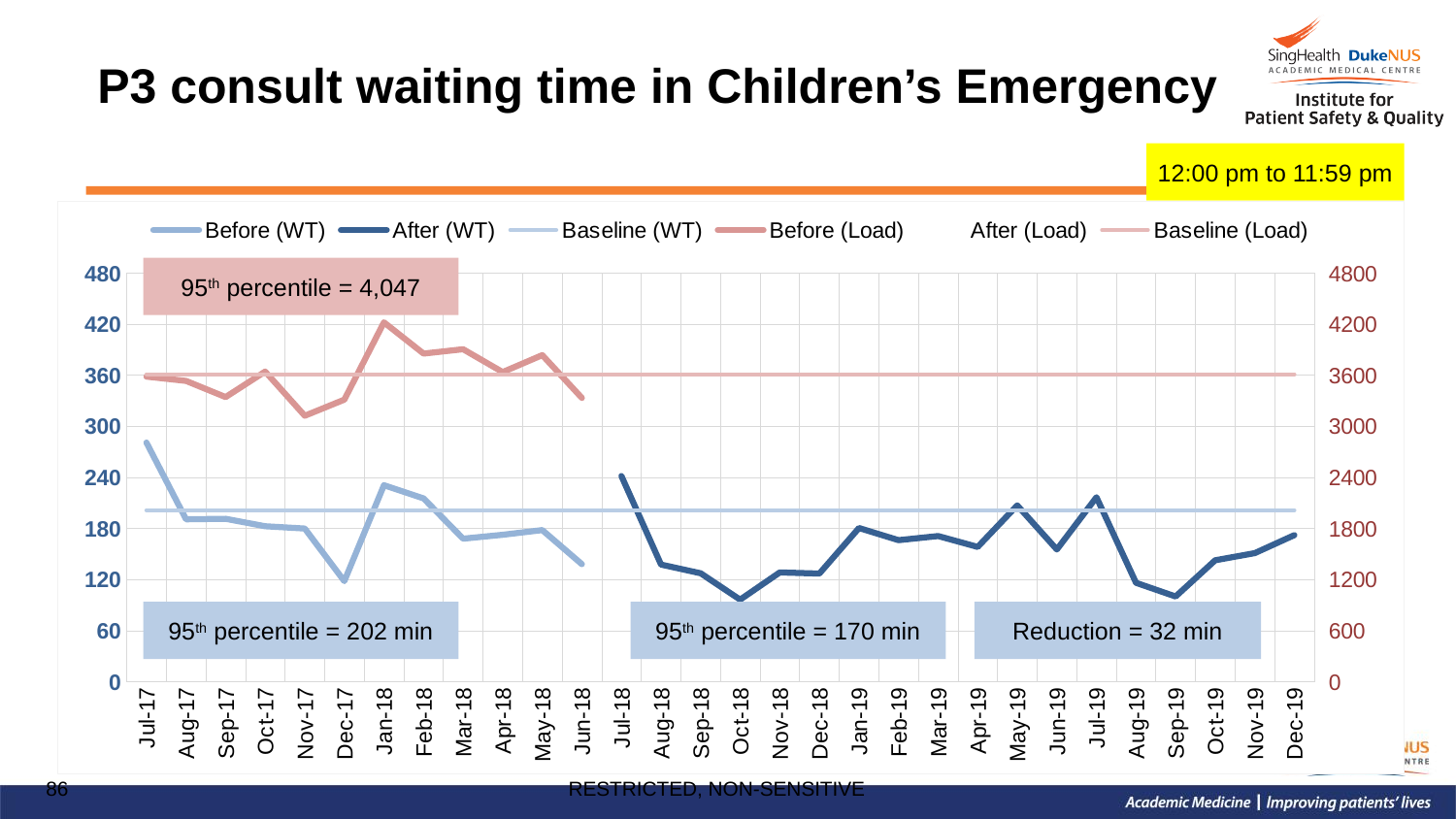
How many months are shown along the x axis of the chart? 30 What is the 95th percentile load value shown in the annotation box? 4,047 How many series does the chart legend list? 6 What is the 95th percentile waiting time shown for the After period? 170 min What is the difference between the Before and After 95th percentile waiting times? 32 min What kind of chart is shown on the slide? line chart Is the Before (WT) value for Jul-17 greater or less than 240? greater What time window is stated in the yellow box on the slide? 12:00 pm to 11:59 pm What is the 95th percentile waiting time shown for the Before period? 202 min Is the After (WT) value for Oct-18 greater or less than 120? less In which month does the Before (WT) series reach its lowest value? Dec-17 In which month does the Before (Load) series reach its highest value? Jan-18